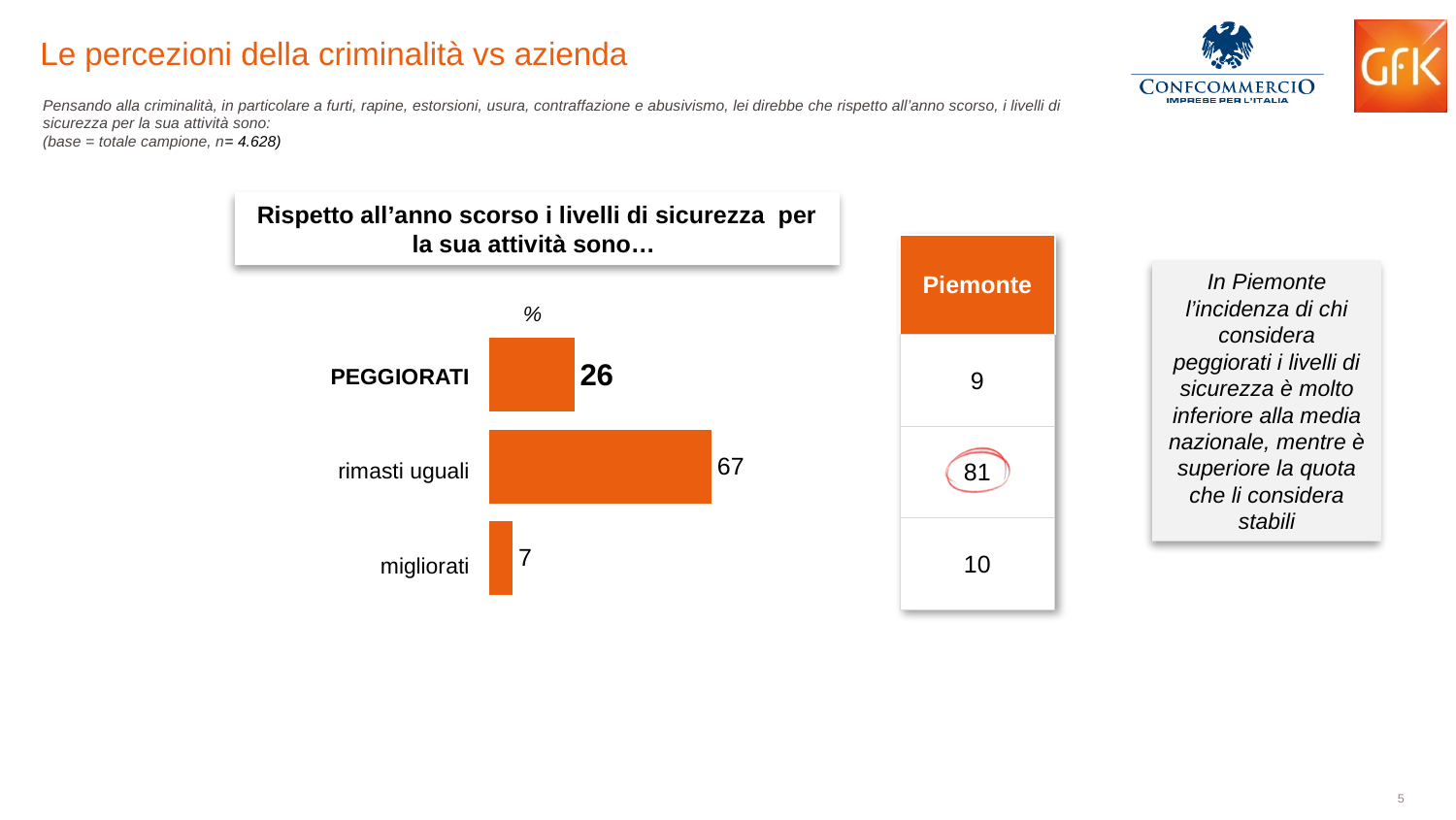
How many categories are shown in the bar chart? 3 Which category has the highest value in the bar chart? rimasti uguali What kind of chart is shown on the slide? bar chart What is the value for PEGGIORATI in the bar chart? 26 What is the difference between the values for 'rimasti uguali' and PEGGIORATI? 41 Which category has the lowest value in the bar chart? migliorati What is the value for 'rimasti uguali' in the bar chart? 67 What is the value for 'migliorati' in the bar chart? 7 Which is larger in the bar chart, PEGGIORATI or 'migliorati'? PEGGIORATI In the Piemonte column next to the chart, what is the value for 'rimasti uguali'? 81 What unit is indicated above the bars in the chart? % What is the difference between the values for PEGGIORATI and 'migliorati'? 19